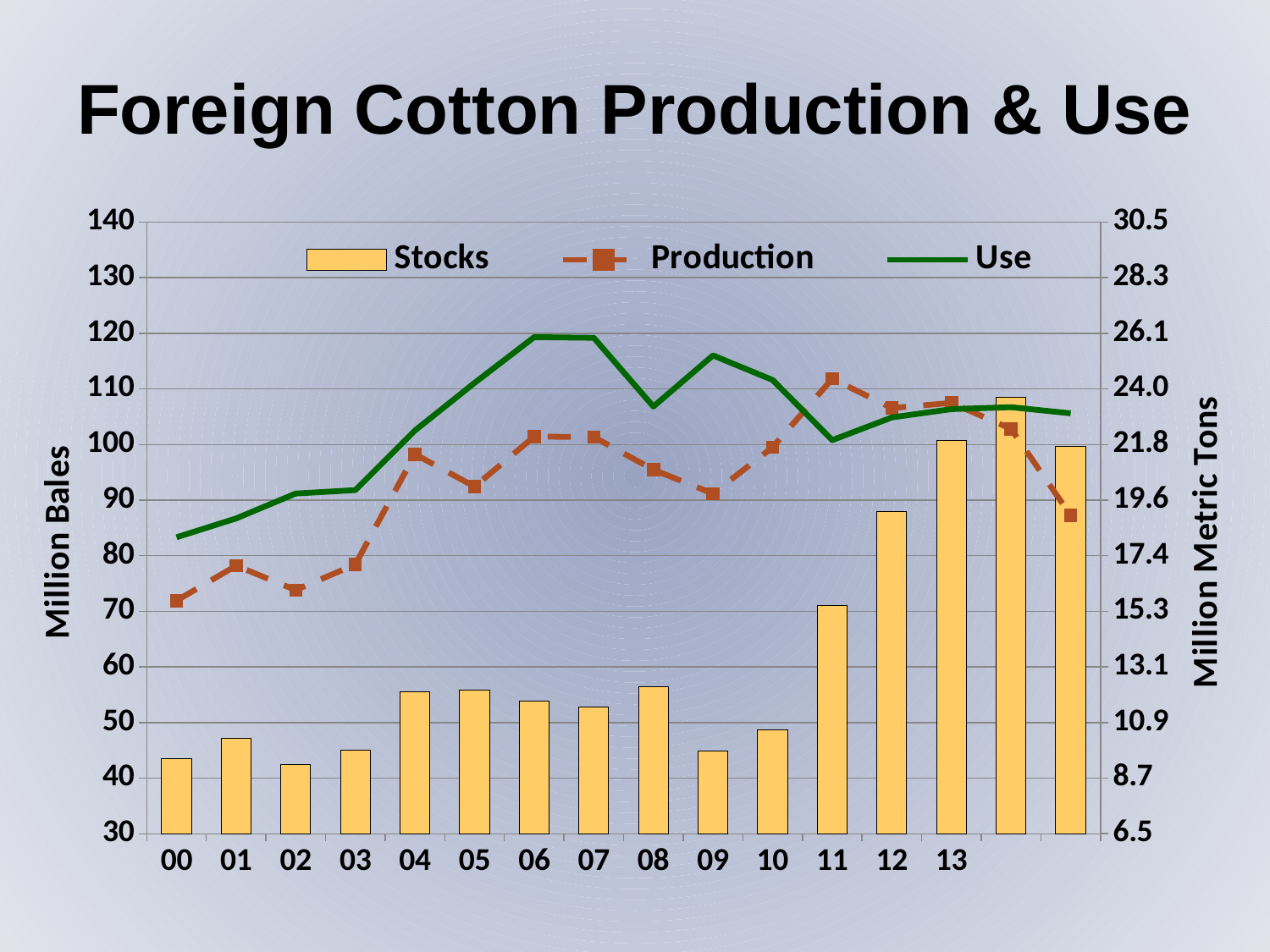
Is the Production line for 00 greater or less than 17.4 on the right axis? less How many year labels are shown on the x axis? 14 Do the Stocks bars rise or fall from 10 to 13? rise How many series does the legend list? 3 In 11, which is higher, Production or Use? Production Is the Stocks bar for 09 greater or less than 50 on the left axis? less In which year does the Production line reach its highest point? 11 What is the title of the left vertical axis? Million Bales What are the three series named in the legend? Stocks, Production, Use Is the Use line for 06 greater or less than 24.0 on the right axis? greater What kind of chart is shown on the slide? A combination bar and line chart